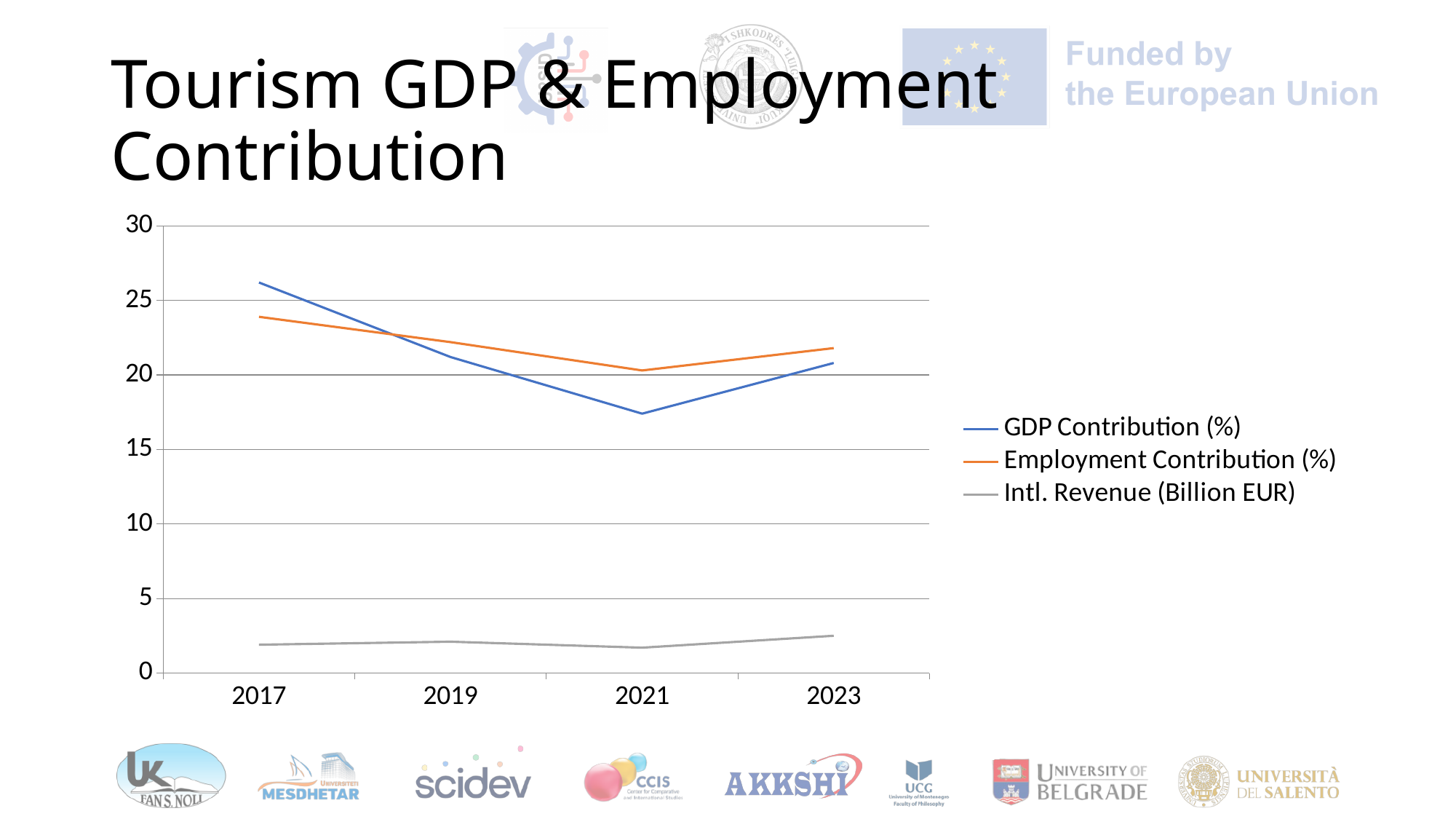
How many years are plotted along the x axis? 4 In which year is GDP Contribution (%) lowest? 2021 In 2017, which is larger: GDP Contribution (%) or Employment Contribution (%)? GDP Contribution (%) Is the GDP Contribution (%) value for 2017 greater or less than 25? greater How many series does the legend list? 3 In which year is Employment Contribution (%) lowest? 2021 Does GDP Contribution (%) rise or fall from 2017 to 2021? fall In 2021, which is larger: GDP Contribution (%) or Employment Contribution (%)? Employment Contribution (%) What kind of chart is shown on the slide? line chart Is the Intl. Revenue (Billion EUR) value for 2023 greater or less than 5? less Is the GDP Contribution (%) value for 2021 greater or less than 20? less In which year is GDP Contribution (%) highest? 2017